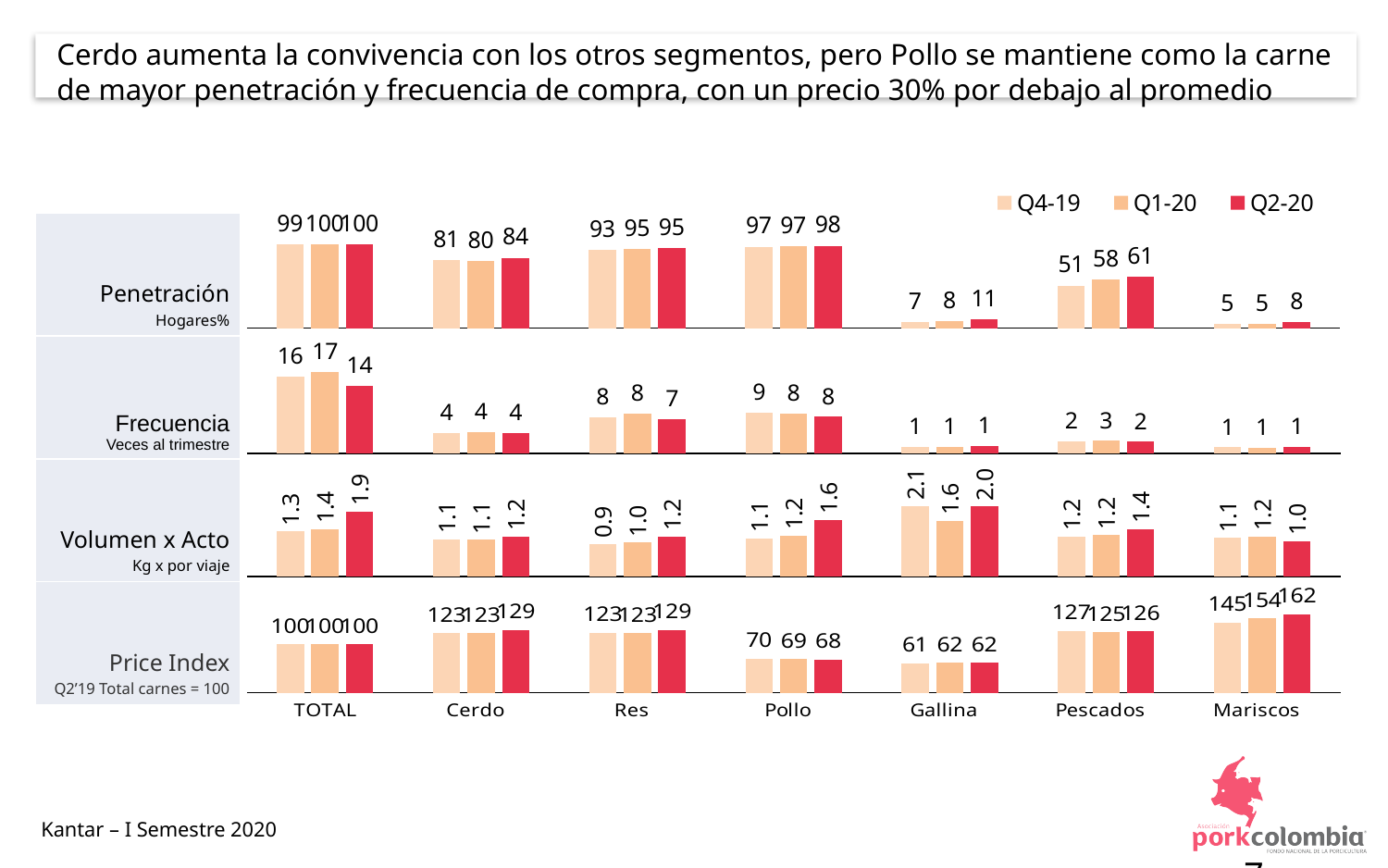
In the Price Index chart, do the values for Mariscos rise or fall from Q4-19 to Q2-20? rise In the Penetración chart, which category has the lowest Q2-20 value? Mariscos What kind of chart is used in the Penetración panel? bar chart In the Price Index chart, what is the difference between the Q2-20 values for Cerdo and Pollo? 61 In the Penetración chart, what is the value for Cerdo in Q2-20? 84 In the Frecuencia chart, what is the value for TOTAL in Q1-20? 17 In the Penetración chart, which is larger: the Q2-20 value for Pescados or the Q2-20 value for Gallina? Pescados How many categories are shown along the x axis of the charts? 7 How many series does the legend list? 3 In the Frecuencia chart, which category has the highest Q2-20 value, excluding TOTAL? Pollo In the Volumen x Acto chart, what is the value for Gallina in Q4-19? 2.1 In the Price Index chart, what is the value for Mariscos in Q2-20? 162